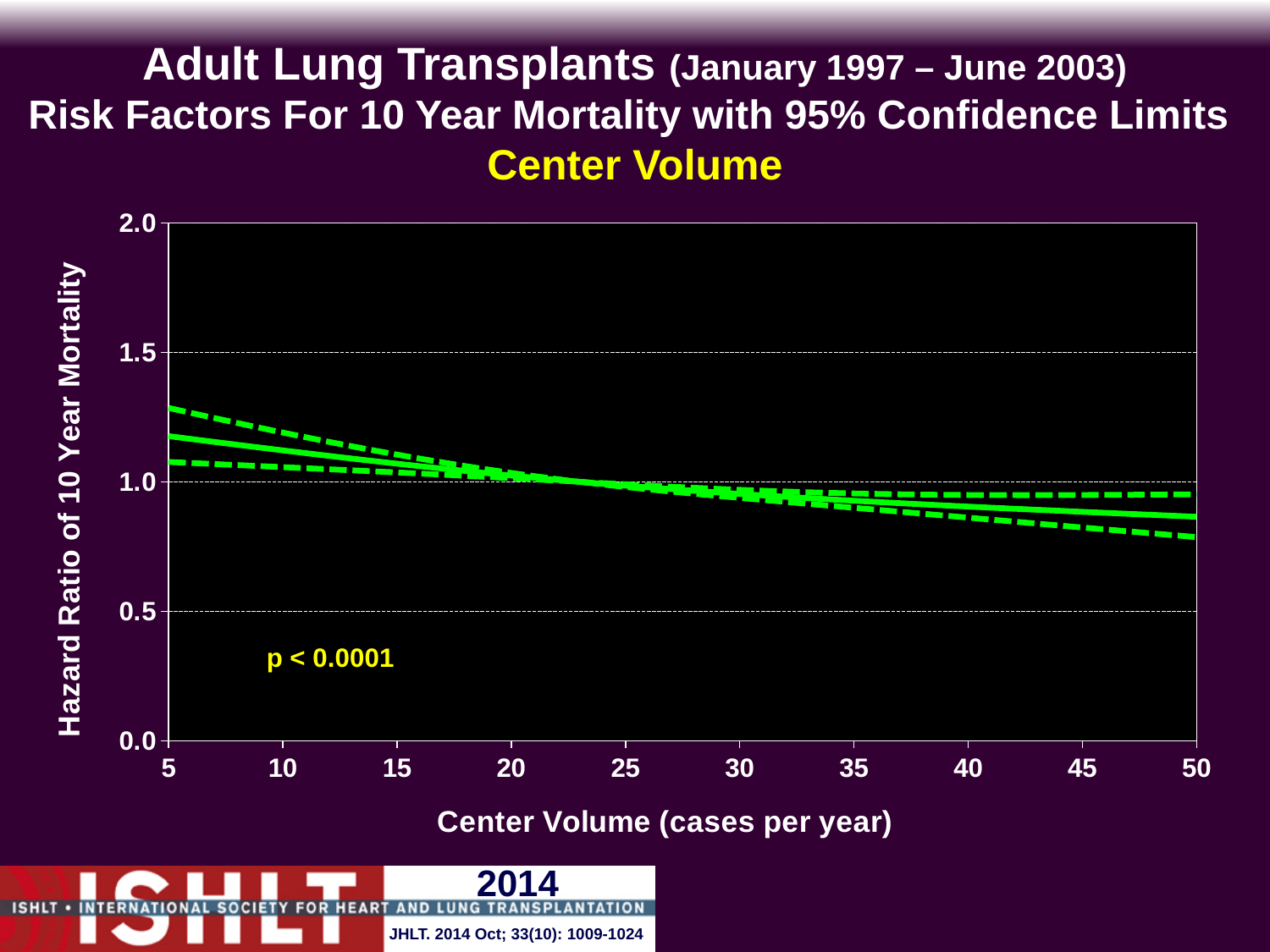
Is the upper 95% confidence limit at a center volume of 5 cases per year greater or less than 1.5? less Is the hazard ratio (solid line) at a center volume of 50 cases per year greater or less than 1.0? less Is the hazard ratio (solid line) larger at a center volume of 10 or at a center volume of 40 cases per year? 10 How many lines are plotted on the chart? 3 What is the label of the x axis? Center Volume (cases per year) Is the lower 95% confidence limit at a center volume of 50 cases per year greater or less than 0.5? greater What p-value is printed on the chart? p < 0.0001 Does the hazard ratio of 10 year mortality rise or fall as center volume increases from 5 to 50 cases per year? fall What kind of chart is shown on the slide? line chart